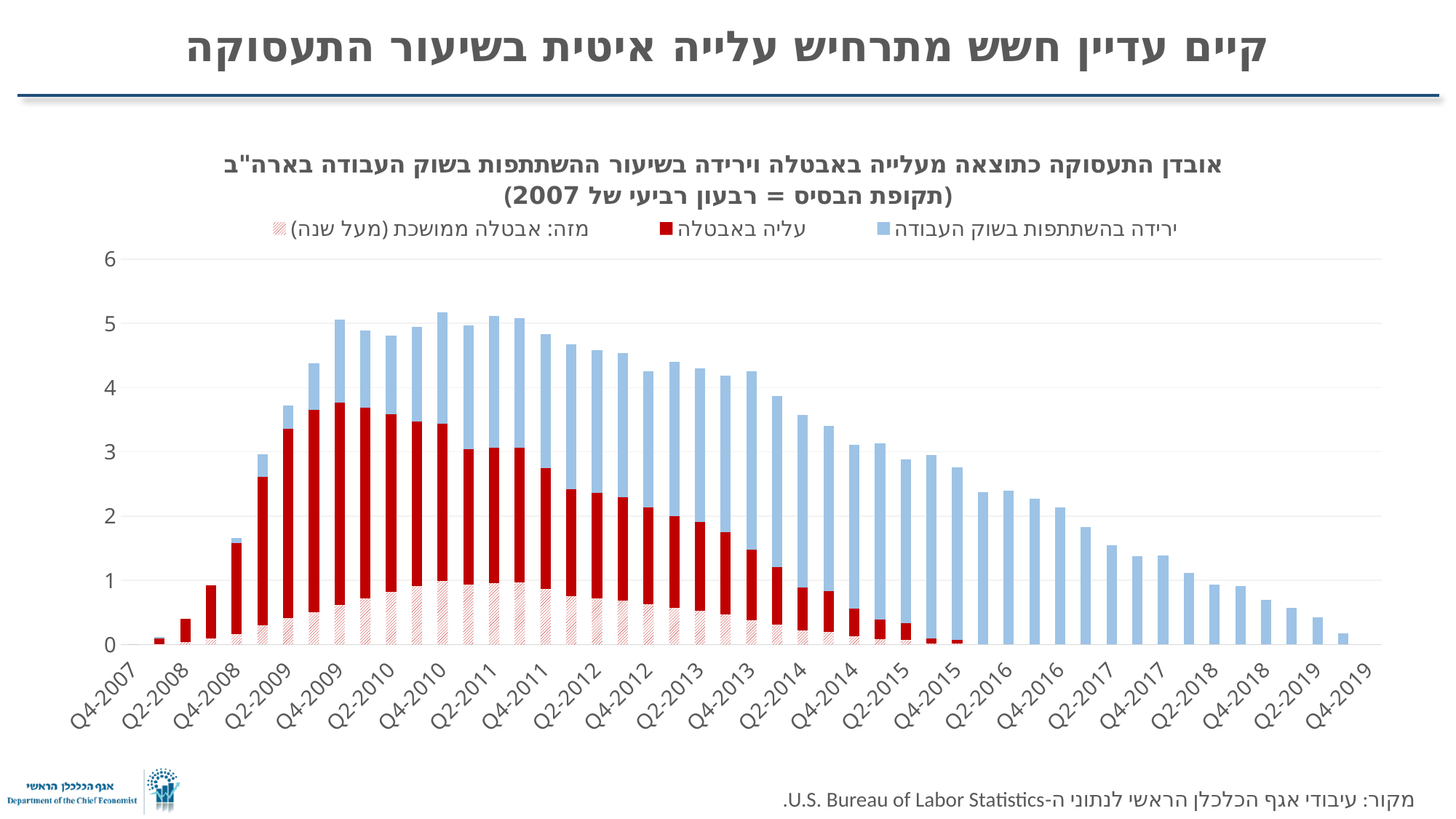
Which bar has the larger total value, Q4-2008 or Q4-2012? Q4-2012 What kind of chart is shown on the slide? stacked bar chart Is the total value of the bar for Q2-2016 greater or less than 3? less How many series does the legend list? 3 Is the total value of the bar for Q4-2019 greater or less than 1? less Is the red segment (עליה באבטלה) for Q4-2009 greater or less than 3? greater Which bar has the larger total value, Q2-2016 or Q2-2018? Q2-2016 Do the total bar values rise or fall from Q2-2016 to Q4-2019? fall Which legend entry is shown in blue? ירידה בהשתתפות בשוק העבודה